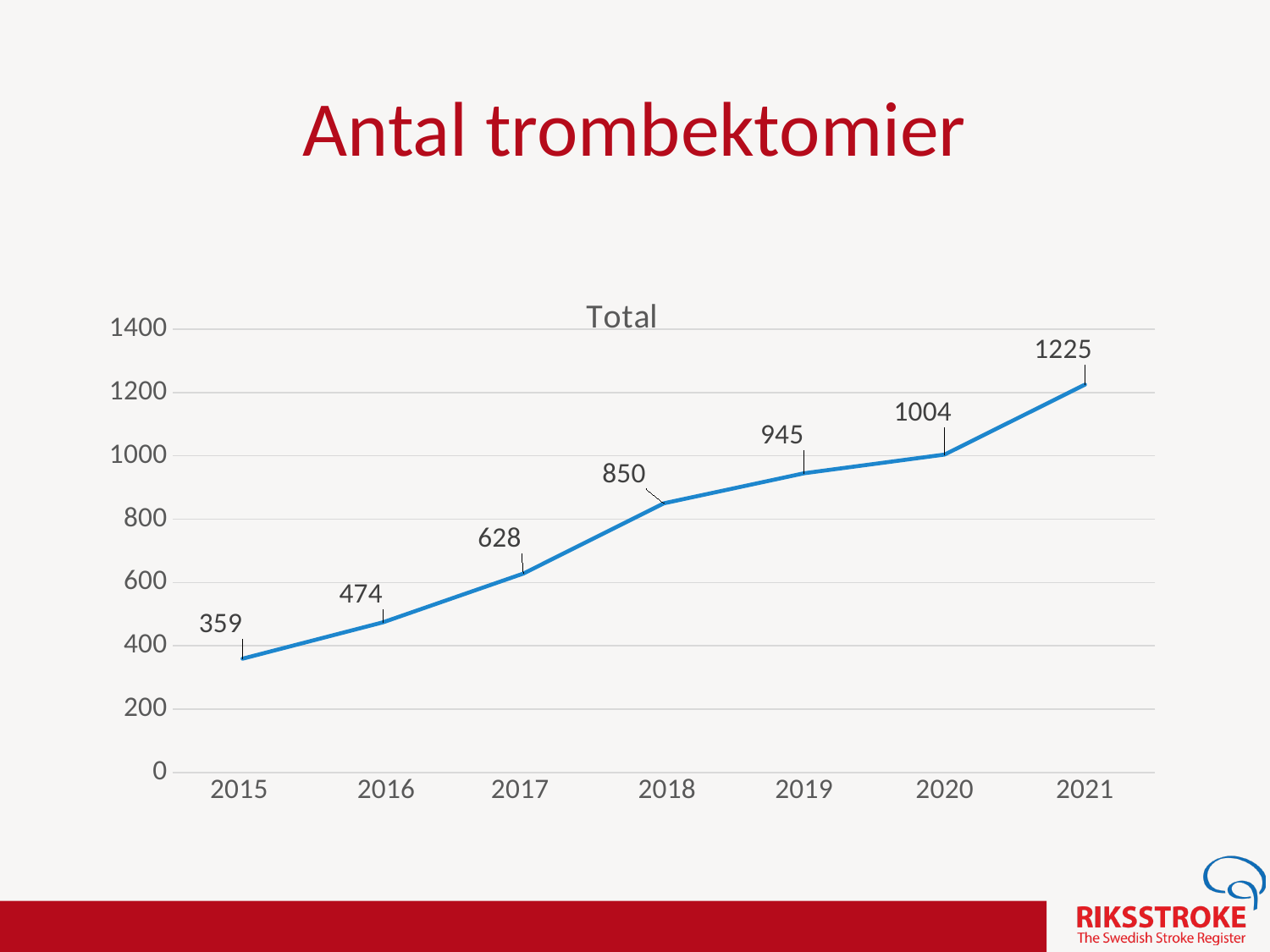
How many years are plotted on the x axis? 7 Which year has the lowest value? 2015 Which year has the highest value? 2021 Do the values rise or fall from 2015 to 2021? rise Which is larger, the value for 2019 or the value for 2018? 2019 What is the difference between the values for 2017 and 2016? 154 What is the difference between the values for 2021 and 2020? 221 Is the value for 2020 greater or less than 800? greater What is the value for 2018? 850 What is the value for 2015? 359 What is the value for 2021? 1225 What kind of chart is shown? line chart